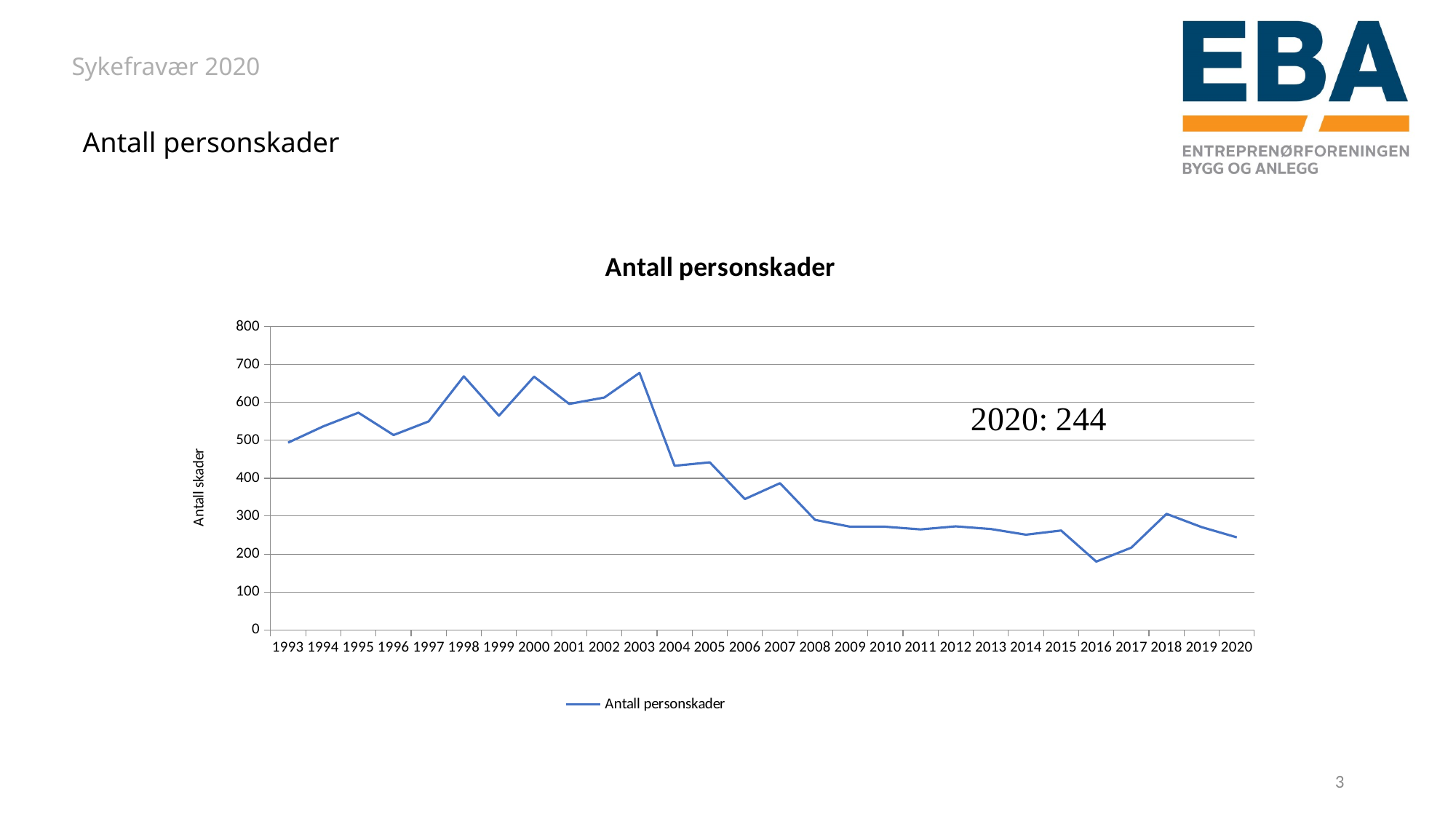
Is the value for 2003 greater or less than 600? greater Which year has the lowest number of personskader? 2016 Which year has the larger value, 1995 or 1996? 1995 Which year has the larger value, 2003 or 2004? 2003 Is the value for 2006 greater or less than 400? less What kind of chart is shown on the slide? line chart Is the value for 2016 greater or less than 200? less How many years are plotted along the x axis? 28 What is the value for 2020 in the Antall personskader chart? 244 What is the label on the vertical axis of the chart? Antall skader Overall, do the values rise or fall from 1993 to 2020? fall How many series does the legend list? 1